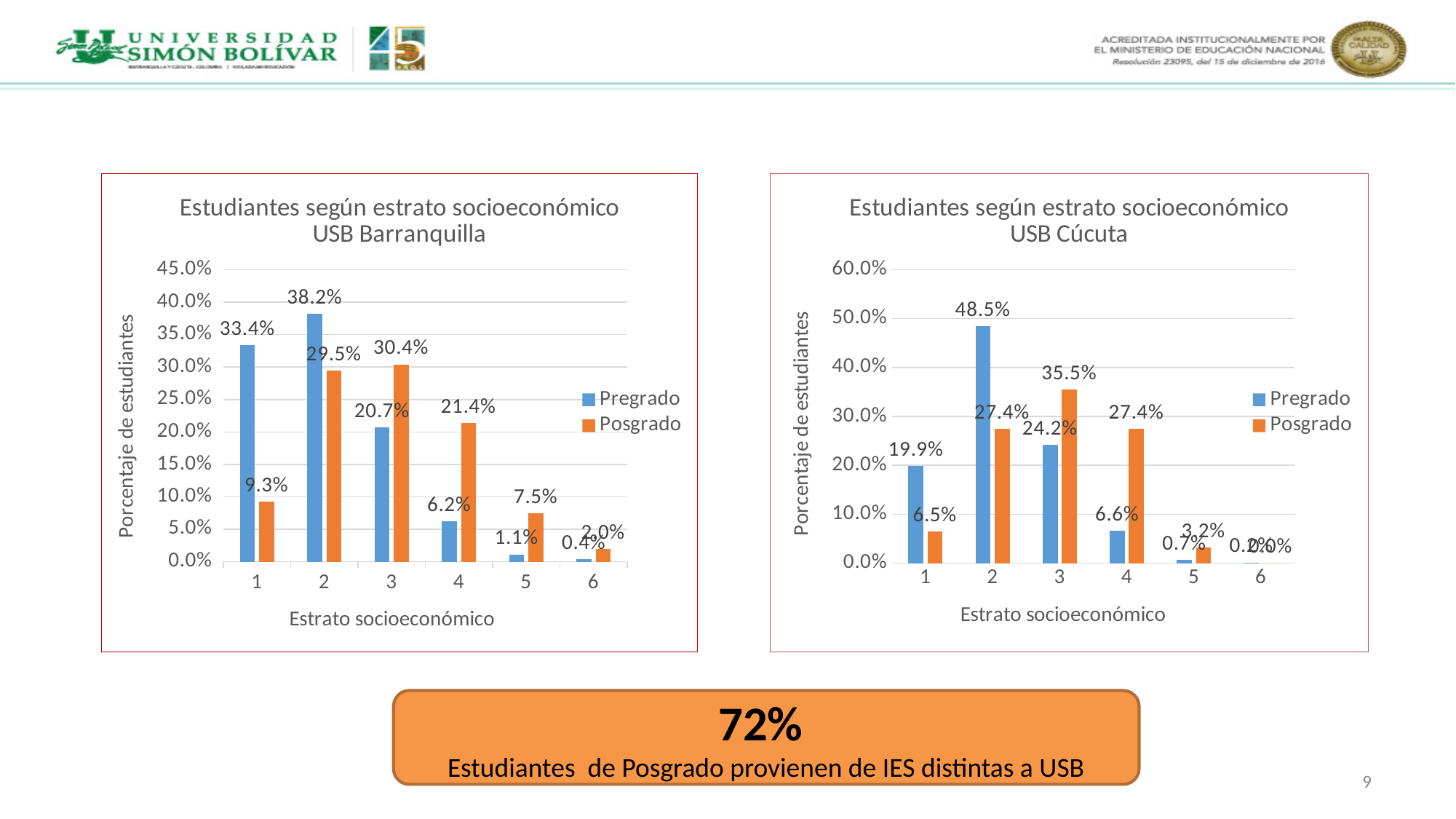
In the 'Estudiantes según estrato socioeconómico USB Cúcuta' chart, what is the Posgrado value for estrato 3? 35.5% In the 'Estudiantes según estrato socioeconómico USB Barranquilla' chart, what is the Posgrado value for estrato 4? 21.4% In the 'Estudiantes según estrato socioeconómico USB Barranquilla' chart, what is the Pregrado value for estrato 2? 38.2% How many series does the legend list in the 'Estudiantes según estrato socioeconómico USB Cúcuta' chart? 2 In the 'Estudiantes según estrato socioeconómico USB Cúcuta' chart, is the Pregrado value for estrato 2 greater or less than 40.0%? greater In the 'Estudiantes según estrato socioeconómico USB Barranquilla' chart, which estrato has the highest Posgrado value? 3 In the 'Estudiantes según estrato socioeconómico USB Barranquilla' chart, what is the difference between the Pregrado and Posgrado values for estrato 1? 24.1% In the 'Estudiantes según estrato socioeconómico USB Cúcuta' chart, which estrato has the highest Pregrado value? 2 In the 'Estudiantes según estrato socioeconómico USB Cúcuta' chart, what is the difference between the Posgrado and Pregrado values for estrato 4? 20.8% In the 'Estudiantes según estrato socioeconómico USB Cúcuta' chart, what is the Pregrado value for estrato 2? 48.5% In the 'Estudiantes según estrato socioeconómico USB Barranquilla' chart, which is larger for estrato 5, Pregrado or Posgrado? Posgrado What type of chart is the 'Estudiantes según estrato socioeconómico USB Barranquilla' chart? Bar chart